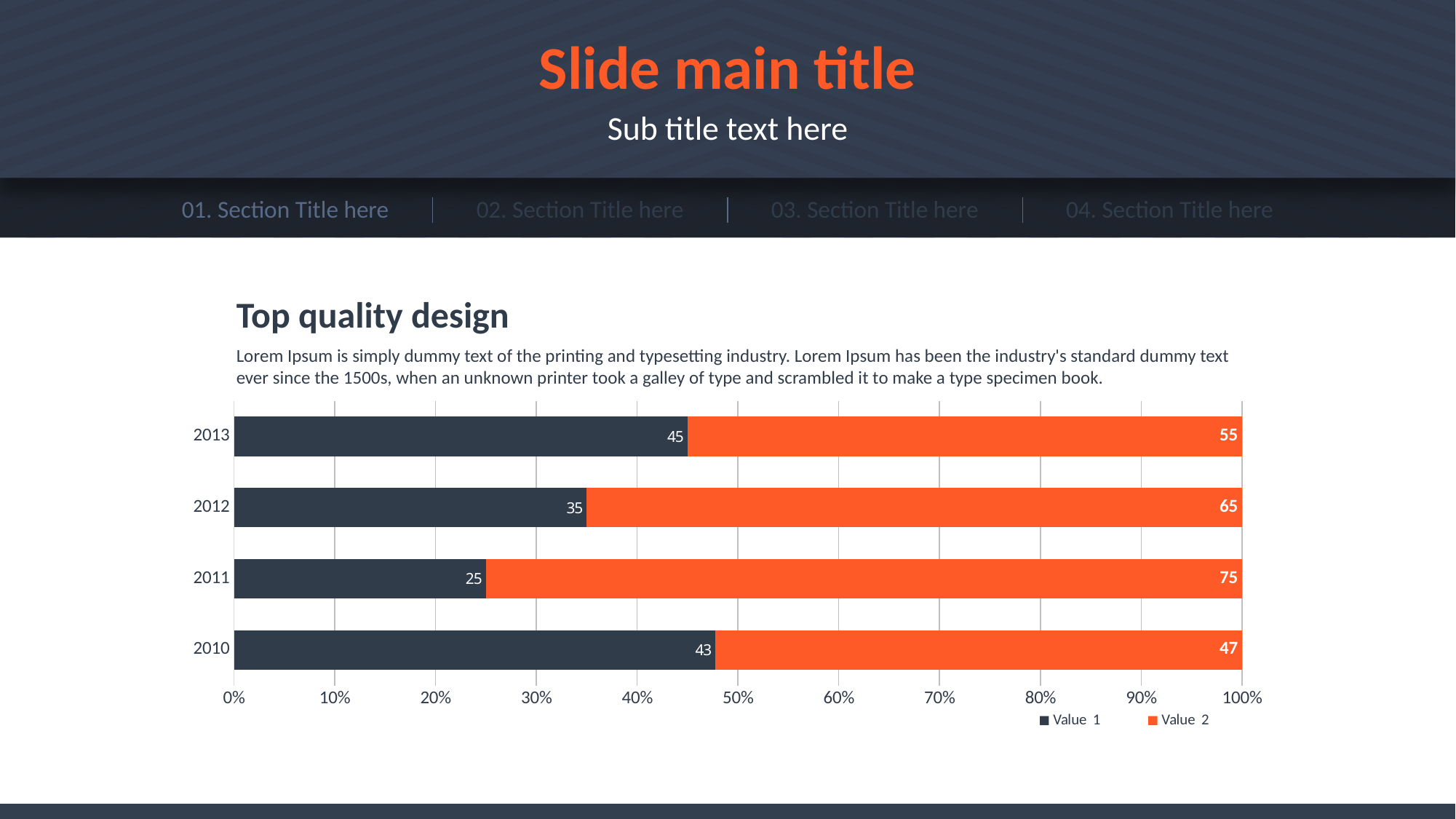
Which year has the lowest Value 1? 2011 How many series does the legend list? 2 Which year has the highest Value 2? 2011 What kind of chart is shown on the slide? Stacked bar chart What is the value of Value 2 for 2012? 65 How many years are shown on the chart? 4 What is the value of Value 1 for 2013? 45 What colour represents Value 2 in the chart? Orange What is the value of Value 2 for 2011? 75 What is the difference between Value 2 and Value 1 for 2012? 30 Which is larger for 2010, Value 1 or Value 2? Value 2 What is the value of Value 1 for 2010? 43